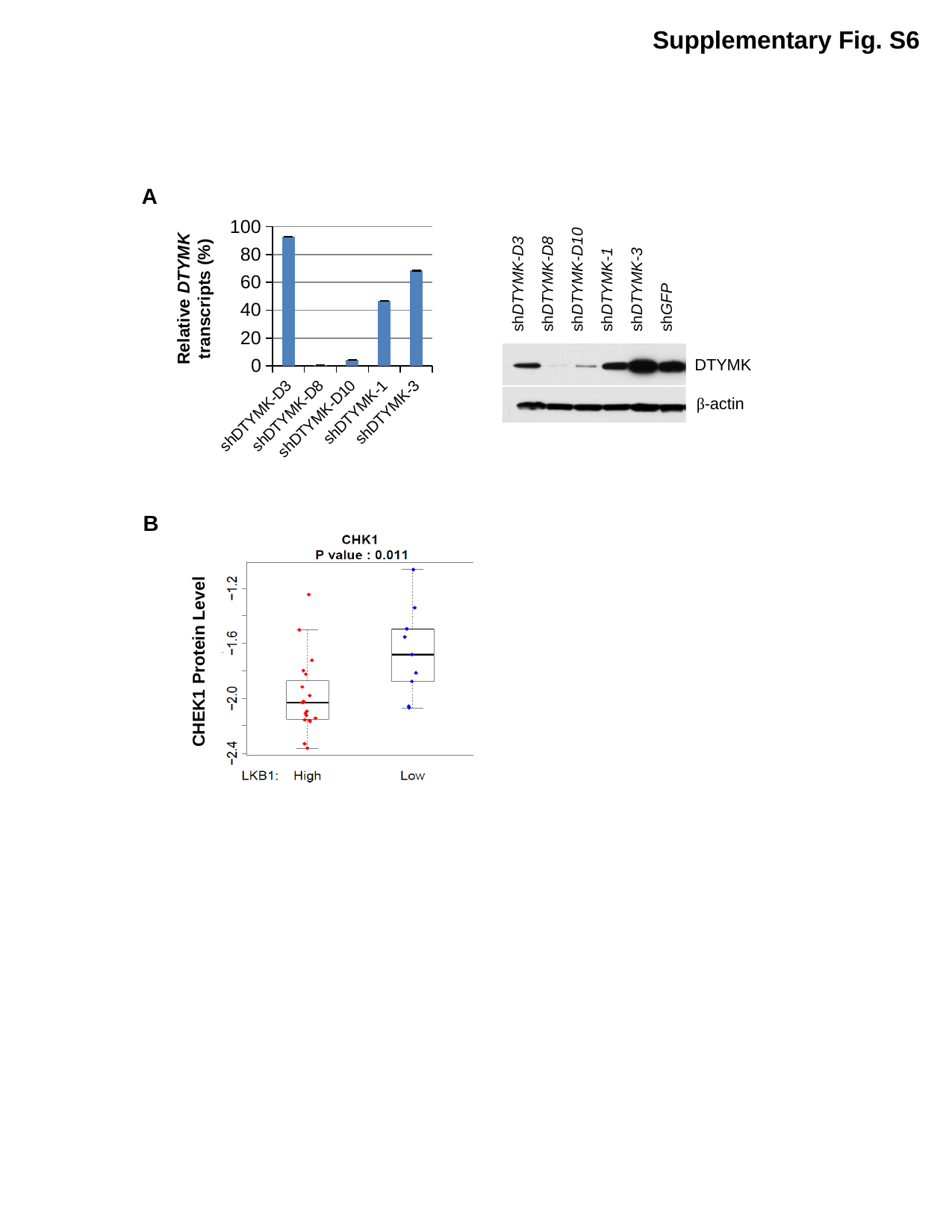
What is the y-axis label of the bar chart in panel A? Relative DTYMK transcripts (%) In the bar chart in panel A, which category has the highest relative DTYMK transcript level? shDTYMK-D3 In the box plot in panel B, which LKB1 group has the higher median CHEK1 protein level, High or Low? Low In the bar chart in panel A, is the value for shDTYMK-3 greater or less than 60? greater In the bar chart in panel A, which category has the lowest relative DTYMK transcript level? shDTYMK-D8 What kind of chart is shown in panel A? bar chart How many categories are shown in the bar chart in panel A? 5 In the bar chart in panel A, is the value for shDTYMK-D3 greater or less than 80? greater In the bar chart in panel A, is the value for shDTYMK-D10 greater or less than 20? less What P value is printed on the box plot in panel B? 0.011 In the bar chart in panel A, which is larger, the value for shDTYMK-1 or shDTYMK-3? shDTYMK-3